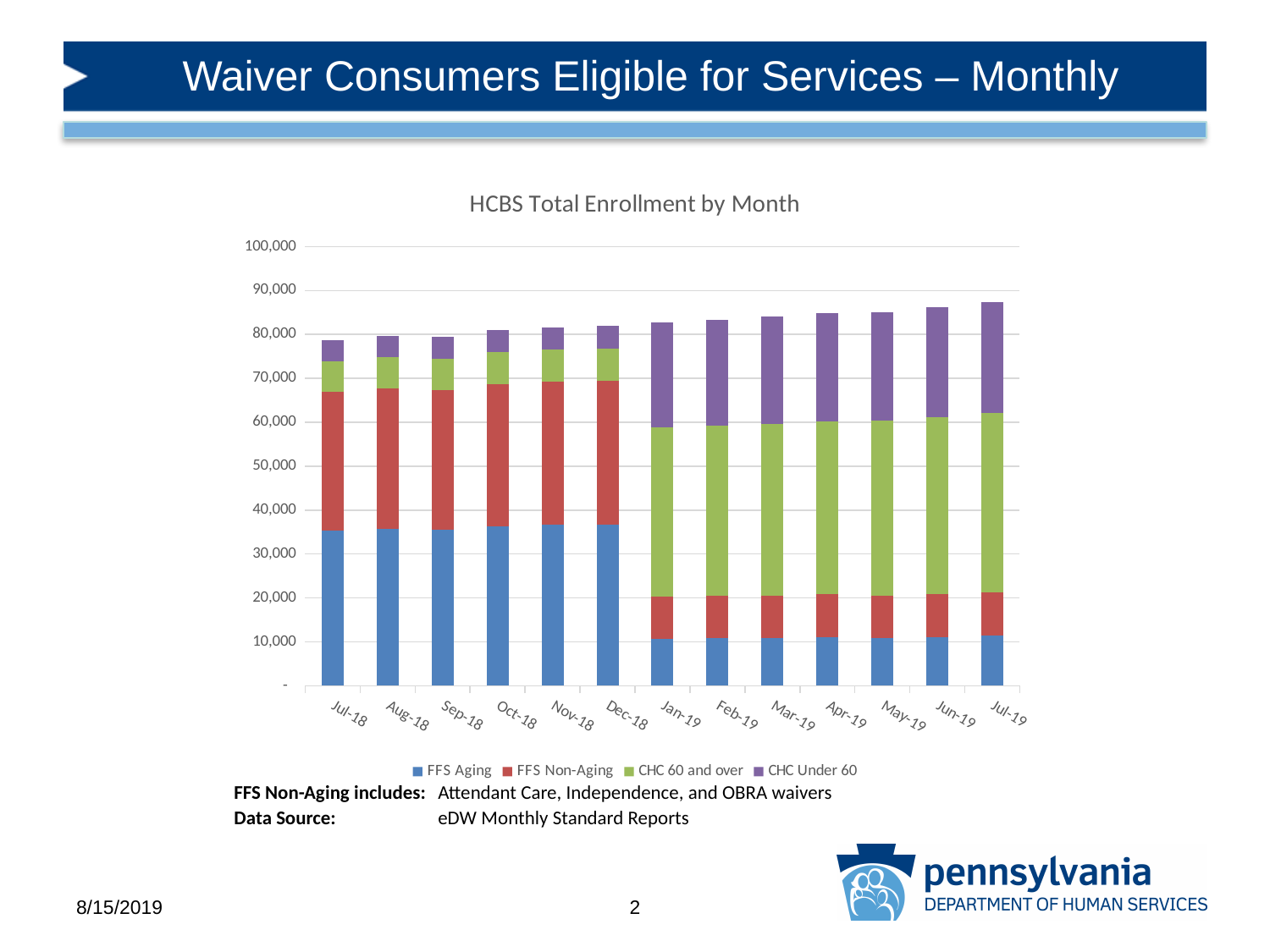
Is the total enrollment for Jul-18 greater or less than 80,000? less How many months are shown along the x axis of the chart? 13 What is the title of the chart? HCBS Total Enrollment by Month Is the FFS Aging value for Jul-18 greater or less than 30,000? greater Does the total enrollment generally rise or fall from Jul-18 to Jul-19? Rise What kind of chart is shown on the slide? Stacked bar chart How many series does the chart's legend list? 4 Is the FFS Aging value for Jan-19 greater or less than 20,000? less Which month has the highest total enrollment bar? Jul-19 Which month has the larger FFS Aging value, Dec-18 or Jan-19? Dec-18 Which series is shown in green in the chart? CHC 60 and over